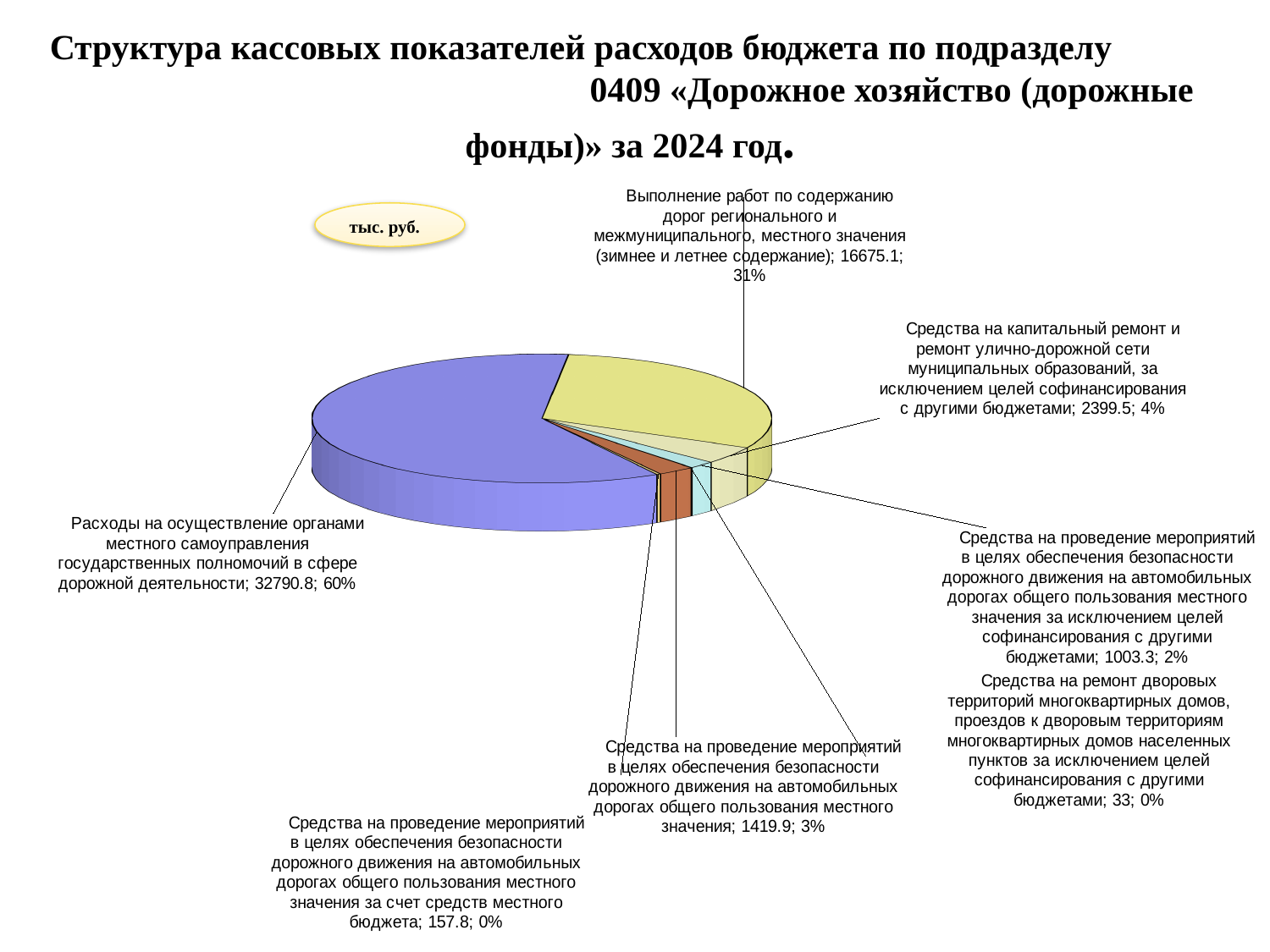
What share of the pie does «Выполнение работ по содержанию дорог регионального и межмуниципального, местного значения (зимнее и летнее содержание)» represent? 31% How many slices does the pie chart have? 7 Which category has the smallest value in the pie chart? Средства на ремонт дворовых территорий многоквартирных домов, проездов к дворовым территориям многоквартирных домов населенных пунктов за исключением целей софинансирования с другими бюджетами In what units are the values in the chart given, according to the label on the slide? тыс. руб. What is the value for «Средства на капитальный ремонт и ремонт улично-дорожной сети муниципальных образований, за исключением целей софинансирования с другими бюджетами»? 2399.5 Which category has the largest slice of the pie? Расходы на осуществление органами местного самоуправления государственных полномочий в сфере дорожной деятельности What is the difference between the value for «Расходы на осуществление органами местного самоуправления государственных полномочий в сфере дорожной деятельности» (32790.8) and «Выполнение работ по содержанию дорог регионального и межмуниципального, местного значения (зимнее и летнее содержание)» (16675.1)? 16115.7 What is the value for «Выполнение работ по содержанию дорог регионального и межмуниципального, местного значения (зимнее и летнее содержание)»? 16675.1 Which is larger: the value for «Средства на проведение мероприятий в целях обеспечения безопасности дорожного движения на автомобильных дорогах общего пользования местного значения» (1419.9) or for «Средства на капитальный ремонт и ремонт улично-дорожной сети муниципальных образований, за исключением целей софинансирования с другими бюджетами» (2399.5)? Средства на капитальный ремонт и ремонт улично-дорожной сети муниципальных образований, за исключением целей софинансирования с другими бюджетами What share of the pie does «Расходы на осуществление органами местного самоуправления государственных полномочий в сфере дорожной деятельности» represent? 60% What type of chart is shown on the slide? pie chart What is the value for «Расходы на осуществление органами местного самоуправления государственных полномочий в сфере дорожной деятельности»? 32790.8